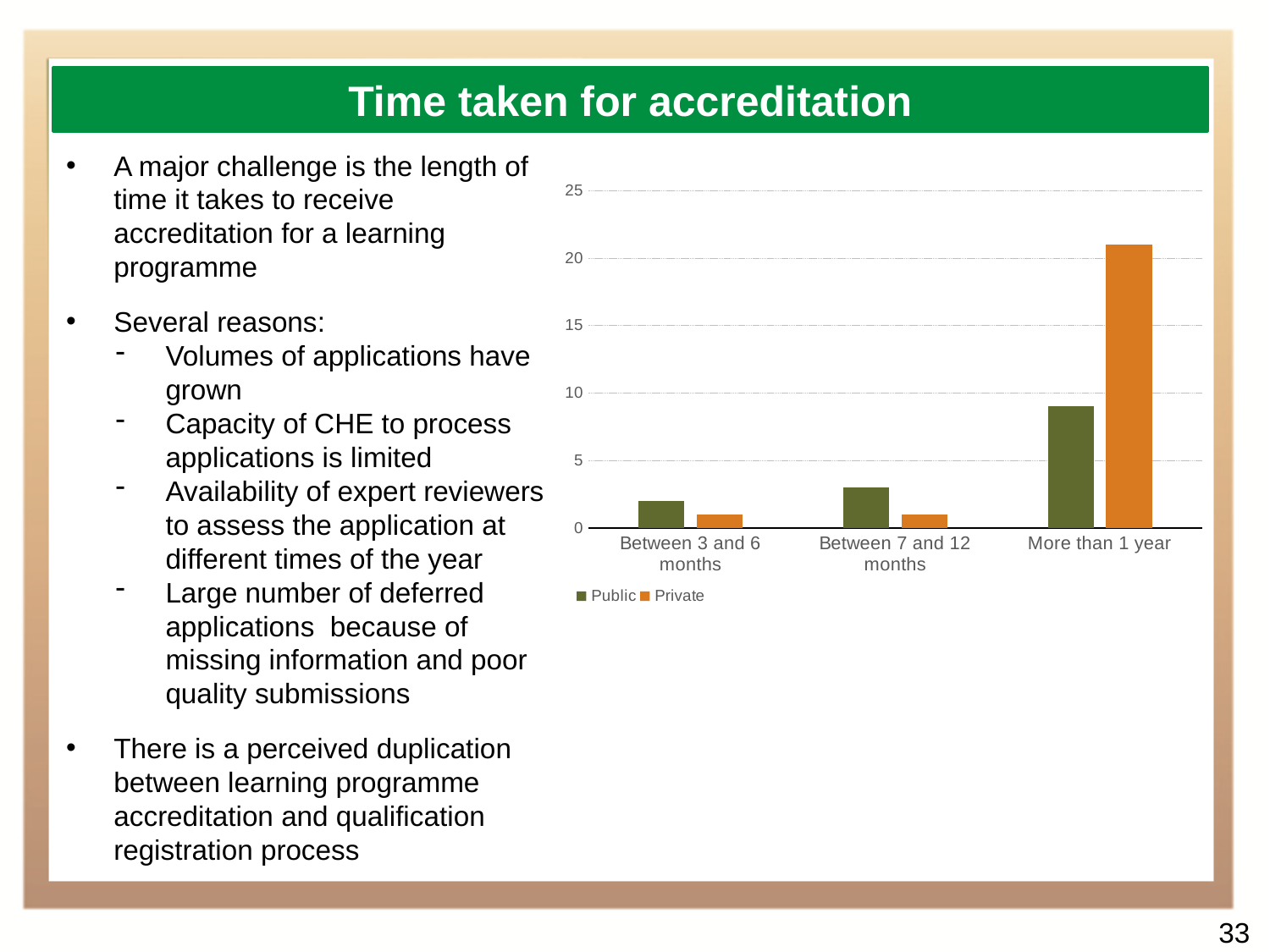
How many series does the chart legend list? 2 What are the two series named in the chart legend? Public and Private Is the Private value for More than 1 year greater or less than 20? greater Is the Public value for More than 1 year greater or less than 10? less How many categories are shown on the x axis of the chart? 3 Which category has the highest Public value? More than 1 year For Between 7 and 12 months, which is larger, the Public value or the Private value? Public Which category has the highest Private value? More than 1 year Is the Public value for Between 7 and 12 months greater or less than 5? less For More than 1 year, which is larger, the Public value or the Private value? Private What kind of chart is shown on the slide? bar chart Do the Private values rise or fall moving from Between 3 and 6 months to More than 1 year? rise